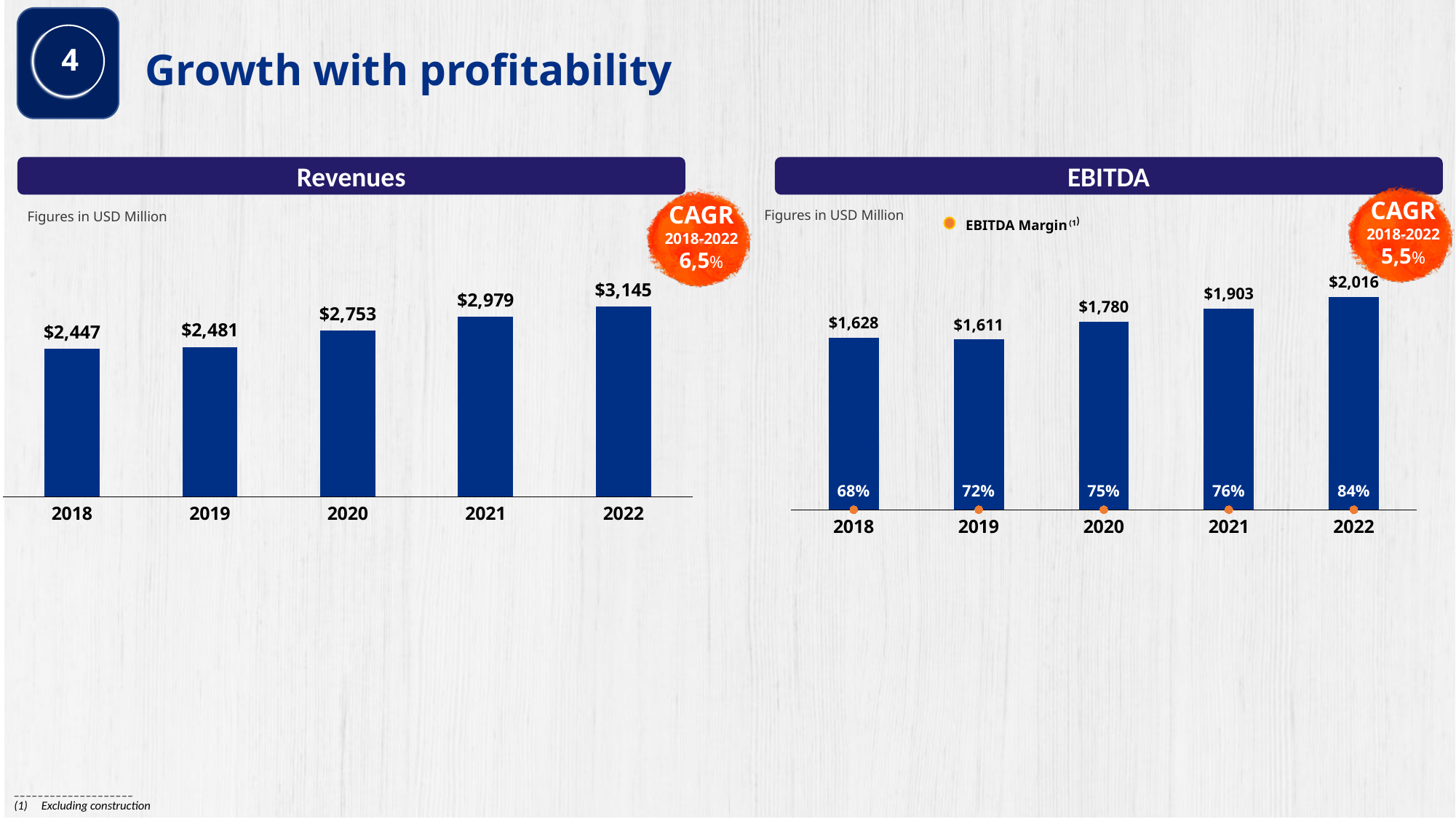
In the EBITDA chart, what is the EBITDA value for 2021? $1,903 In the EBITDA chart, does the EBITDA Margin rise or fall from 2018 to 2022? rise In the Revenues chart, what is the difference between the 2022 and 2018 values? $698 In the Revenues chart, what is the value for 2020? $2,753 In the EBITDA chart, which year has the lowest EBITDA? 2019 What type of chart is the Revenues chart? bar chart How many years are shown in the Revenues chart? 5 In the EBITDA chart, is the EBITDA for 2018 larger or smaller than for 2019? larger In the Revenues chart, which year has the highest revenue? 2022 What CAGR for 2018-2022 is shown on the Revenues chart? 6,5% In the EBITDA chart, what is the EBITDA Margin for 2019? 72% In the EBITDA chart, what is the difference between the EBITDA values for 2020 and 2019? $169